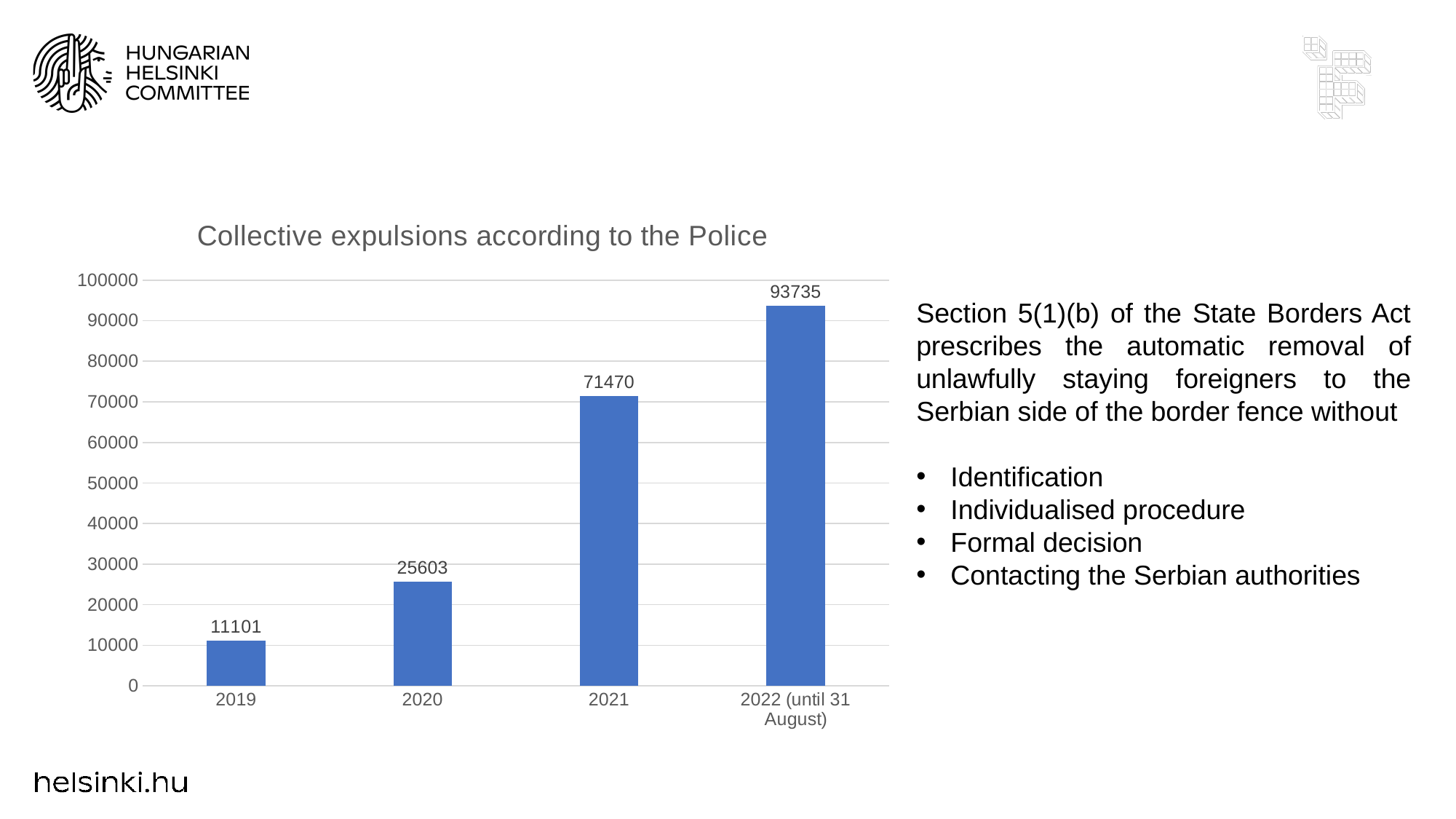
Which category has the lowest value? 2019 What is the value for 2019 in the chart? 11101 Which is larger, the value for 2020 or the value for 2021? 2021 How many categories are shown on the x axis? 4 What kind of chart is shown on the slide? Bar chart Which category has the highest value? 2022 (until 31 August) What is the value for 2020 in the chart? 25603 What is the value for 2022 (until 31 August) in the chart? 93735 What is the difference between the values for 2022 (until 31 August) and 2021? 22265 What is the value for 2021 in the chart? 71470 What is the difference between the values for 2021 and 2020? 45867 Do the values rise or fall from 2019 to 2022 (until 31 August)? Rise